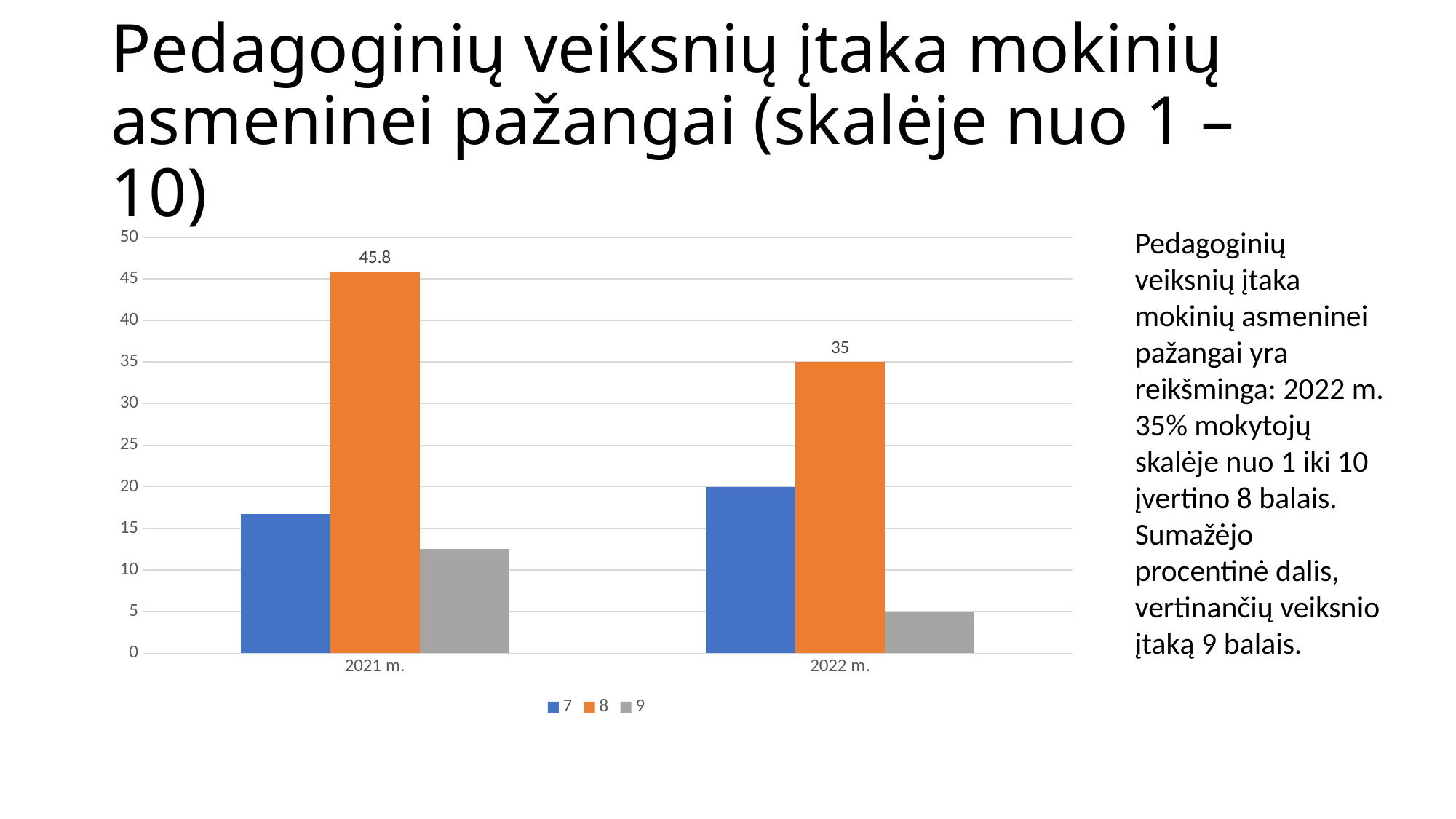
What is the difference between the value for series 8 in 2021 m. and in 2022 m.? 10.8 How many series does the legend list? 3 Which series has the highest value in 2021 m.? 8 Which series has the lowest value in 2022 m.? 9 Is the value for series 9 in 2021 m. greater or less than 10? greater What is the value for series 8 in 2022 m.? 35 How many categories are shown on the x axis? 2 Which is larger: the value for series 7 in 2021 m. or in 2022 m.? 2022 m. What kind of chart is shown on the slide? bar chart Does the value for series 8 rise or fall from 2021 m. to 2022 m.? fall What is the value for series 8 in 2021 m.? 45.8 Is the value for series 7 in 2021 m. greater or less than 20? less